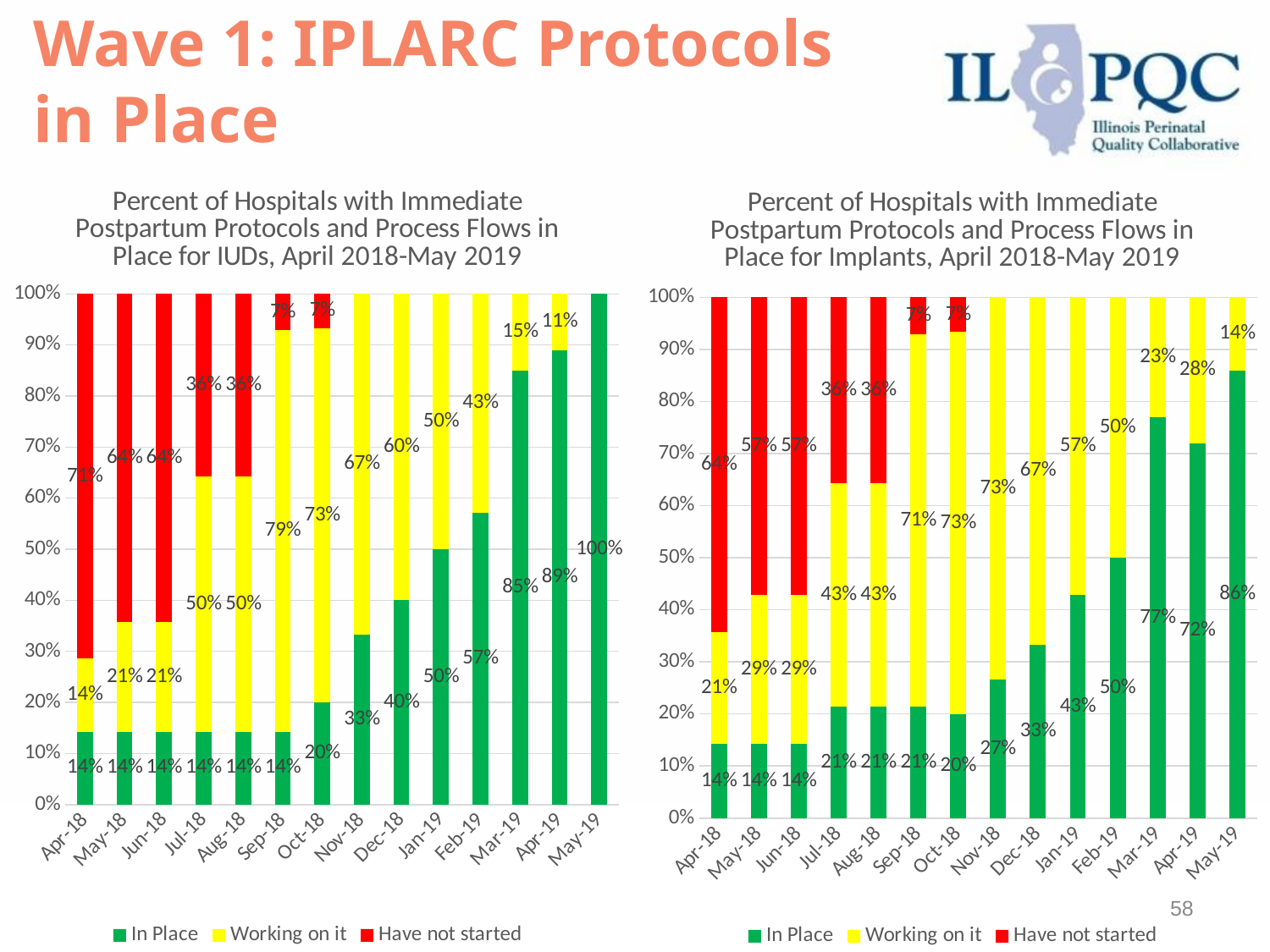
In the Implants chart, what percent of hospitals were Working on it in Mar-19? 23% How many months are shown on the x axis of the IUDs chart? 14 In the IUDs chart, what percent of hospitals had protocols In Place in May-19? 100% In the Implants chart, which is larger: the In Place percentage in Mar-19 or in Apr-19? Mar-19 In the IUDs chart, what is the difference between the In Place percentage in Apr-19 and in Mar-19? 4% In the Implants chart, which month has the highest In Place percentage? May-19 In the Implants chart, does the Have not started percentage rise or fall from Apr-18 to Oct-18? Fall In the Implants chart, what percent of hospitals had protocols In Place in May-19? 86% What kind of chart is the IUDs chart? Stacked bar chart In the IUDs chart, what percent of hospitals had Have not started in Apr-18? 71% How many series does the legend of the Implants chart list? 3